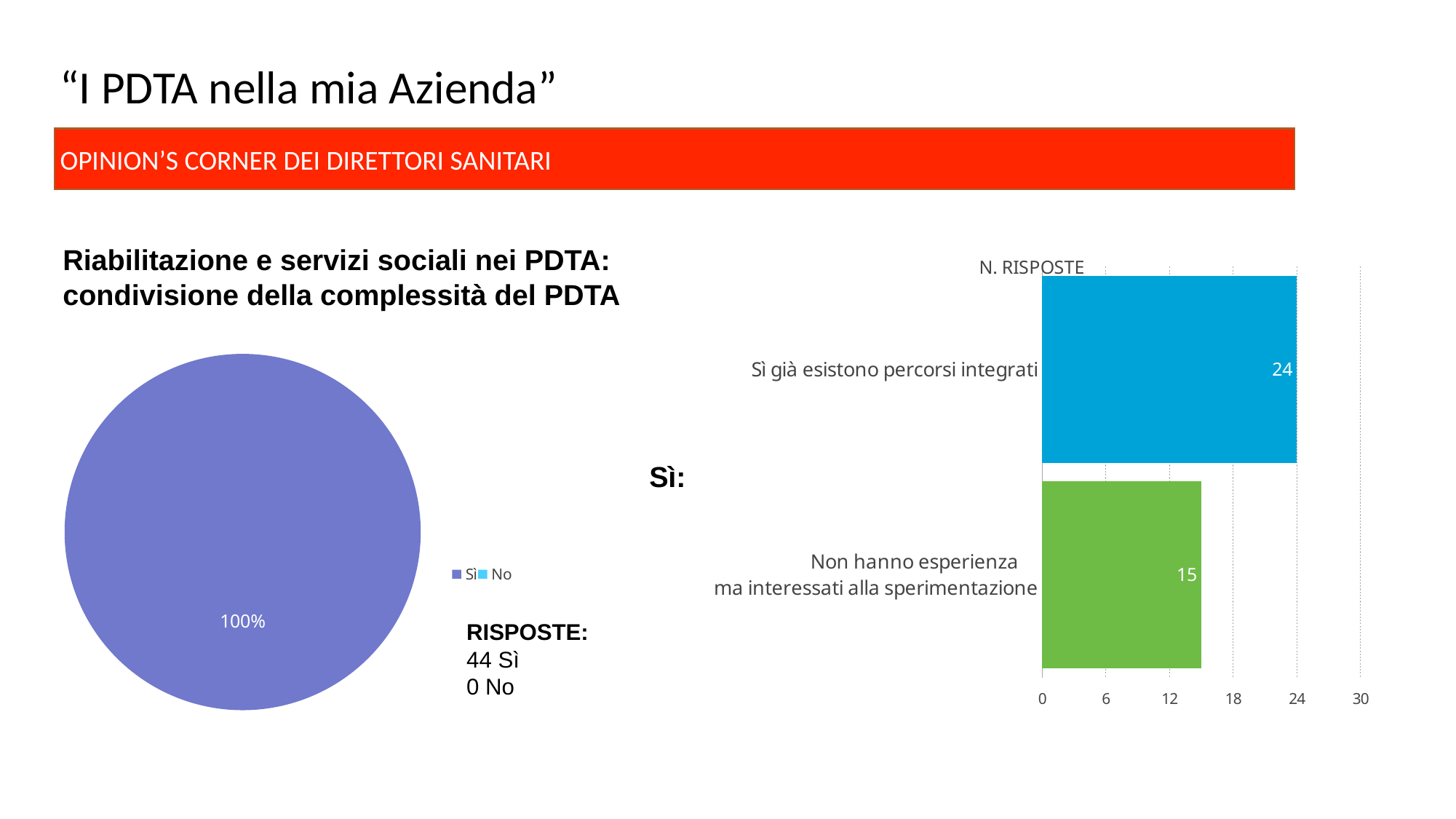
In the bar chart on the right, which is larger: the value for "Sì già esistono percorsi integrati" or for "Non hanno esperienza ma interessati alla sperimentazione"? Sì già esistono percorsi integrati How many entries does the legend of the pie chart on the left list? 2 How many categories does the bar chart on the right show? 2 What is the title of the bar chart on the right? N. RISPOSTE In the bar chart on the right, which category has the lowest value? Non hanno esperienza ma interessati alla sperimentazione In the bar chart on the right, what is the value for "Sì già esistono percorsi integrati"? 24 In the pie chart on the left, what share of the pie does the "Sì" slice take? 100% What kind of chart is the chart on the right of the slide? bar chart In the bar chart on the right, which category has the highest value? Sì già esistono percorsi integrati In the bar chart on the right, what is the value for "Non hanno esperienza ma interessati alla sperimentazione"? 15 In the bar chart on the right, what is the difference between the values for "Sì già esistono percorsi integrati" and "Non hanno esperienza ma interessati alla sperimentazione"? 9 What kind of chart is the chart on the left of the slide? pie chart